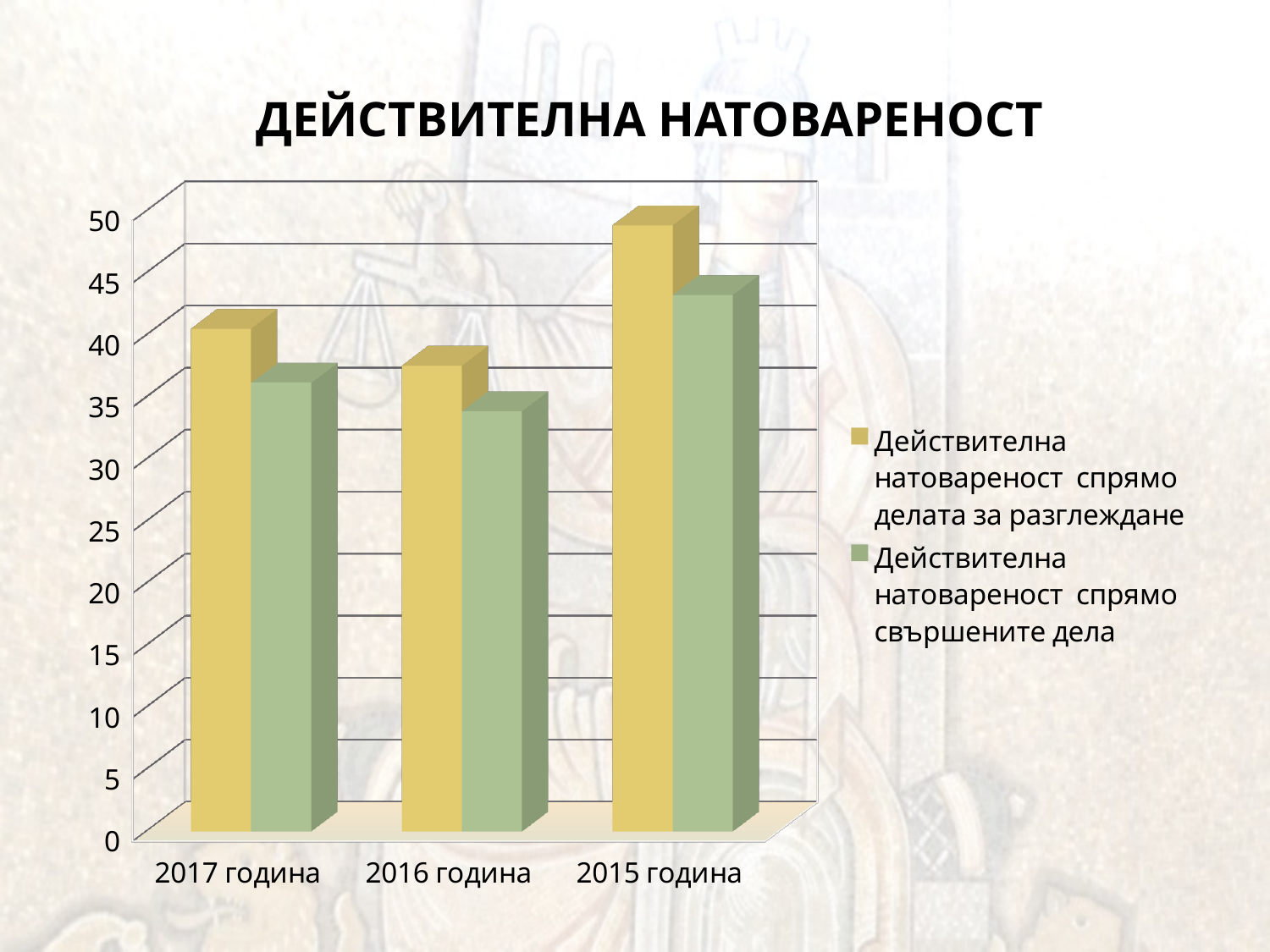
In each year, which series has the taller bar: 'Действителна натовареност спрямо делата за разглеждане' or 'Действителна натовареност спрямо свършените дела'? Действителна натовареност спрямо делата за разглеждане Which year has the lowest value for 'Действителна натовареност спрямо делата за разглеждане'? 2016 година Which is larger: 'Действителна натовареност спрямо делата за разглеждане' in 2017 година or in 2015 година? 2015 година Which year has the lowest value for 'Действителна натовареност спрямо свършените дела'? 2016 година How many series does the legend list? 2 Is the value for 'Действителна натовареност спрямо свършените дела' in 2016 година greater or less than 40? less Is the value for 'Действителна натовареност спрямо свършените дела' in 2015 година greater or less than 40? greater What kind of chart is shown on the slide? bar chart What is the title of the chart? ДЕЙСТВИТЕЛНА НАТОВАРЕНОСТ Which year has the highest value for 'Действителна натовареност спрямо делата за разглеждане'? 2015 година How many categories (years) are shown on the x axis? 3 Is the value for 'Действителна натовареност спрямо делата за разглеждане' in 2015 година greater or less than 45? greater